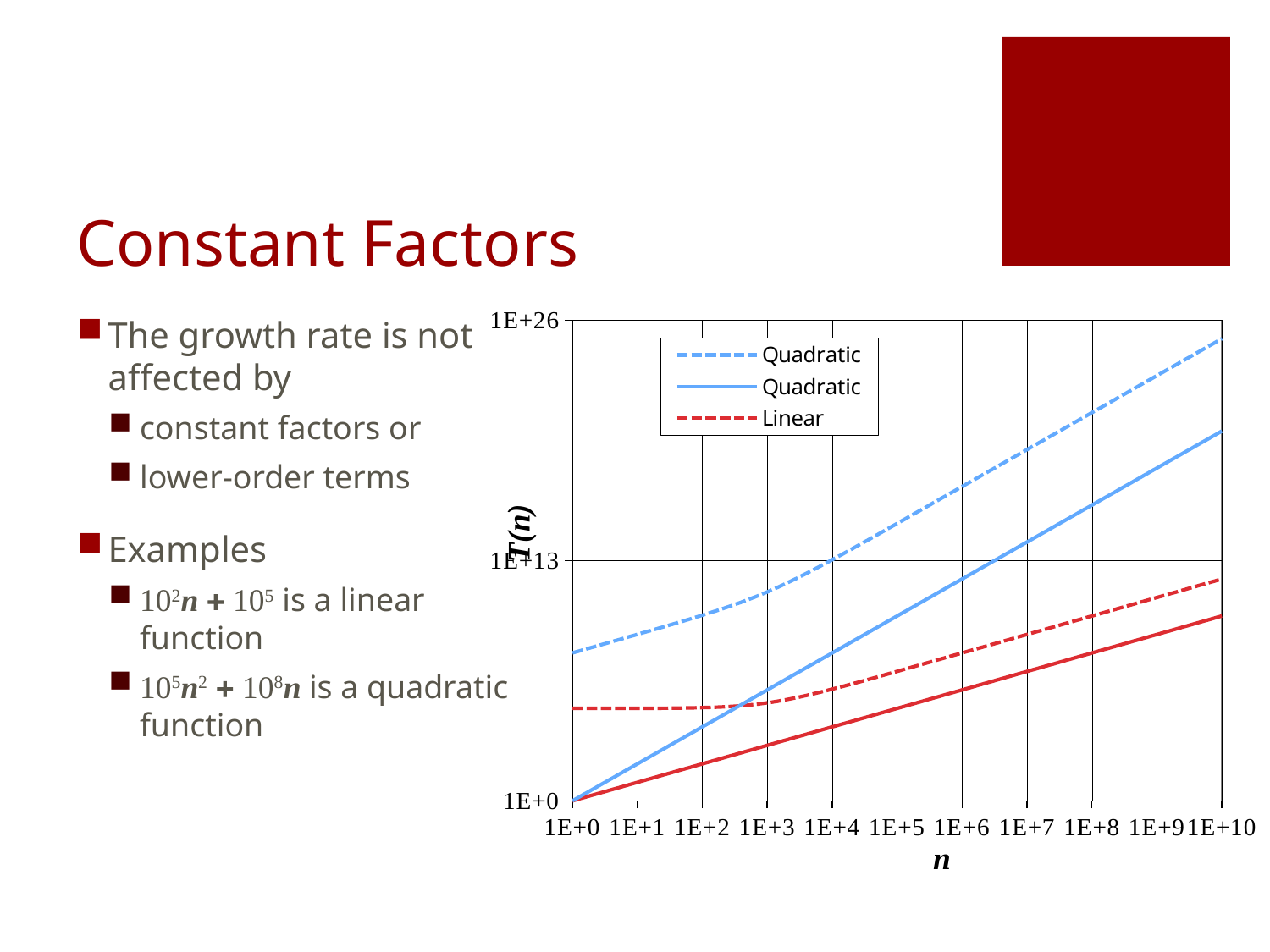
Do the plotted lines rise or fall as n increases along the x axis? rise What is the label of the x axis of the chart? n What is the highest tick value shown on the y axis of the chart? 1E+26 What kind of chart is shown on the slide? line chart How many series does the chart legend list? 3 At n = 1E+10, is the value of the dashed red Linear line greater or less than 1E+13? less At n = 1E+10, which is larger: the dashed blue Quadratic line or the dashed red Linear line? the dashed blue Quadratic line At n = 1E+10, is the value of the dashed blue Quadratic line greater or less than 1E+13? greater At n = 1E+10, which is larger: the solid blue Quadratic line or the dashed blue Quadratic line? the dashed blue Quadratic line At n = 1E+0, is the value of the solid blue Quadratic line greater or less than 1E+13? less How many tick labels are shown along the x axis of the chart? 11